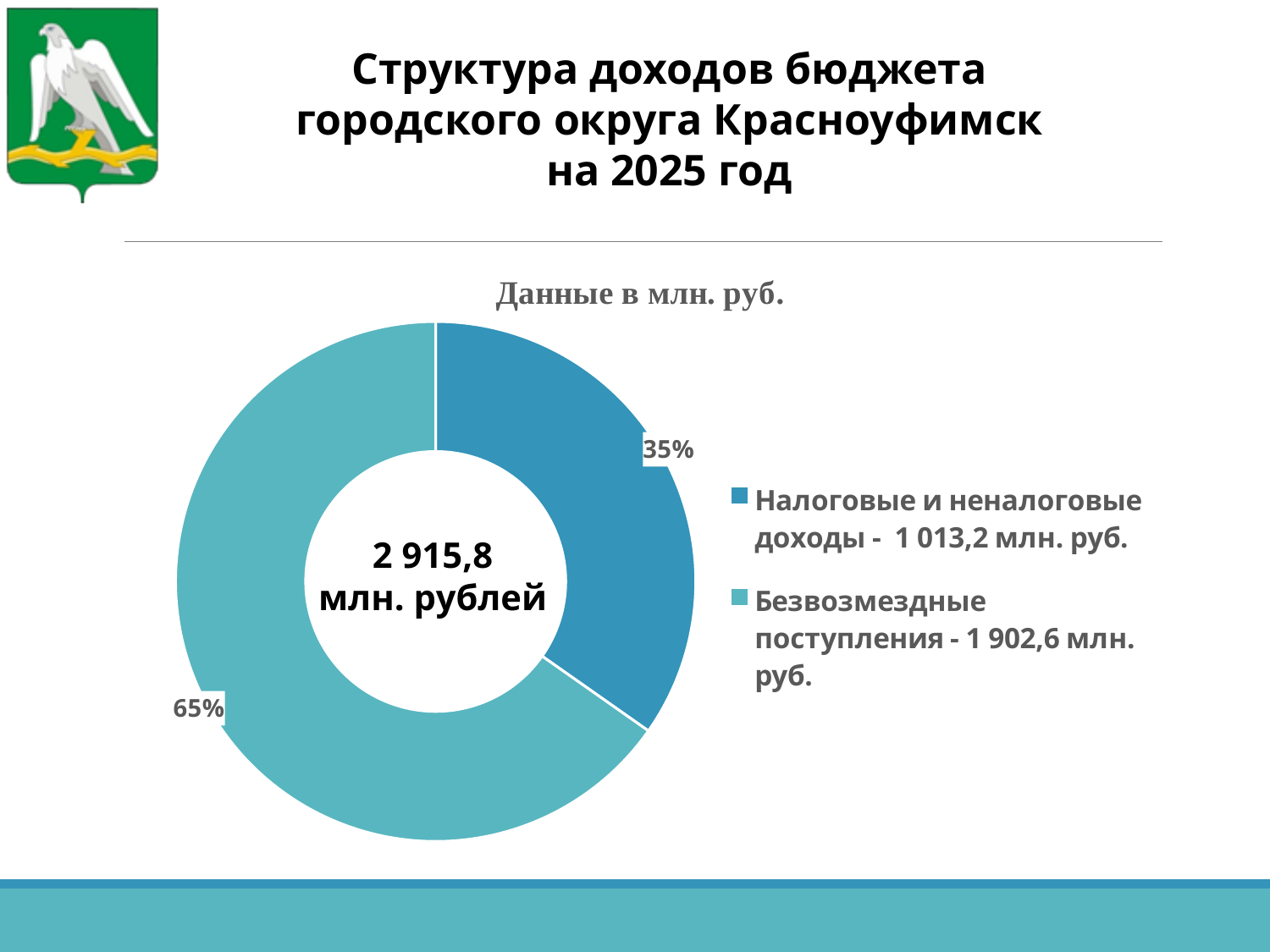
Which category has the largest share of the chart? Безвозмездные поступления What is the value for "Налоговые и неналоговые доходы" according to the legend? 1 013,2 млн. руб. What is the title shown above the chart? Данные в млн. руб. What total value is shown in the centre of the chart? 2 915,8 млн. рублей What share of the chart does "Безвозмездные поступления" take? 65% What is the value for "Безвозмездные поступления" according to the legend? 1 902,6 млн. руб. How many slices does the chart have? 2 What is the difference in percentage points between the two slices? 30 percentage points Which category has the smallest share of the chart? Налоговые и неналоговые доходы What share of the chart does "Налоговые и неналоговые доходы" take? 35% What kind of chart is shown on the slide? Pie chart (doughnut) Which is larger: "Безвозмездные поступления" or "Налоговые и неналоговые доходы"? Безвозмездные поступления